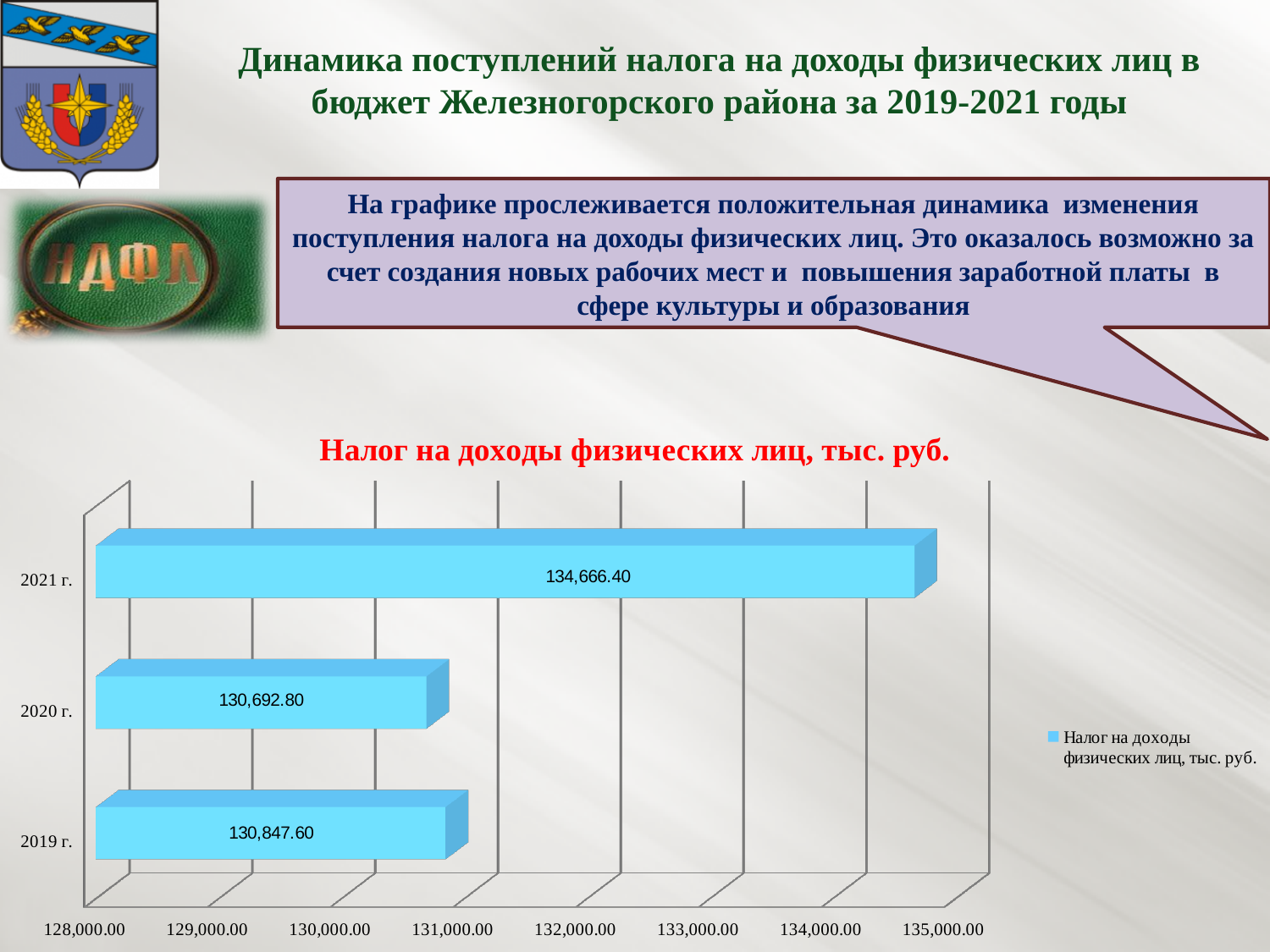
Which year has the lowest value? 2020 г. What is the difference between the values for 2021 г. and 2020 г.? 3,973.60 What is the value for 2020 г.? 130,692.80 What is the difference between the values for 2019 г. and 2020 г.? 154.80 How many years are shown in the chart? 3 Is the value for 2021 г. greater or less than 134,000.00? greater Which is larger, the value for 2019 г. or for 2020 г.? 2019 г. What kind of chart is shown on the slide? bar chart Which year has the highest value? 2021 г. What is the value for 2019 г.? 130,847.60 How many series does the legend list? 1 What is the value for 2021 г.? 134,666.40